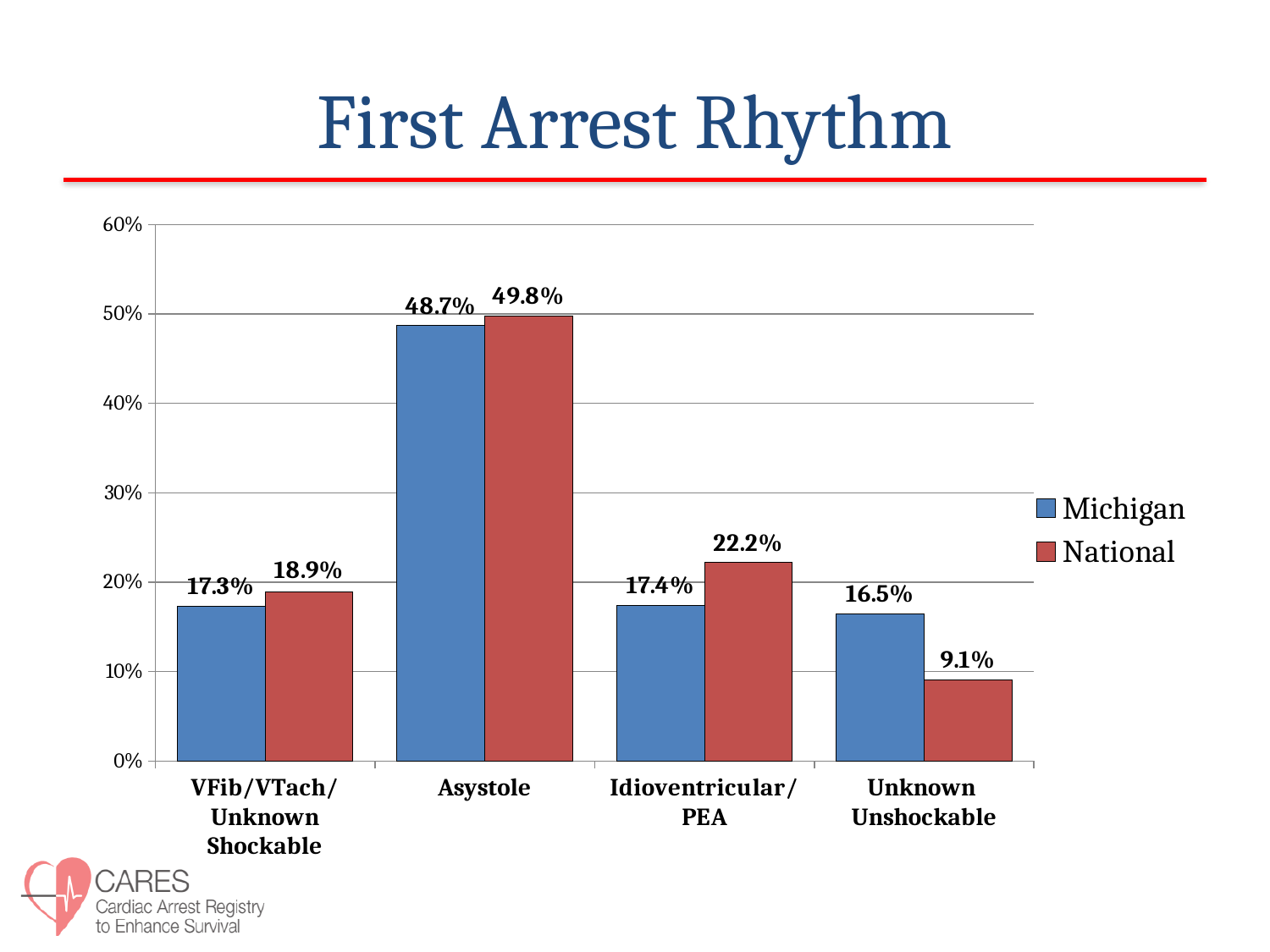
What is the Michigan value for Asystole? 48.7% Which category has the lowest National value? Unknown Unshockable Which category has the highest Michigan value? Asystole What kind of chart is shown on the slide? bar chart What is the National value for Unknown Unshockable? 9.1% What is the difference between the Michigan and National values for Unknown Unshockable? 7.4% For Unknown Unshockable, which is larger: the Michigan value or the National value? Michigan What is the difference between the National and Michigan values for Idioventricular/PEA? 4.8% How many categories are shown on the x axis? 4 What is the National value for Idioventricular/PEA? 22.2% Is the National value for Asystole greater or less than 40%? greater How many series does the legend list? 2